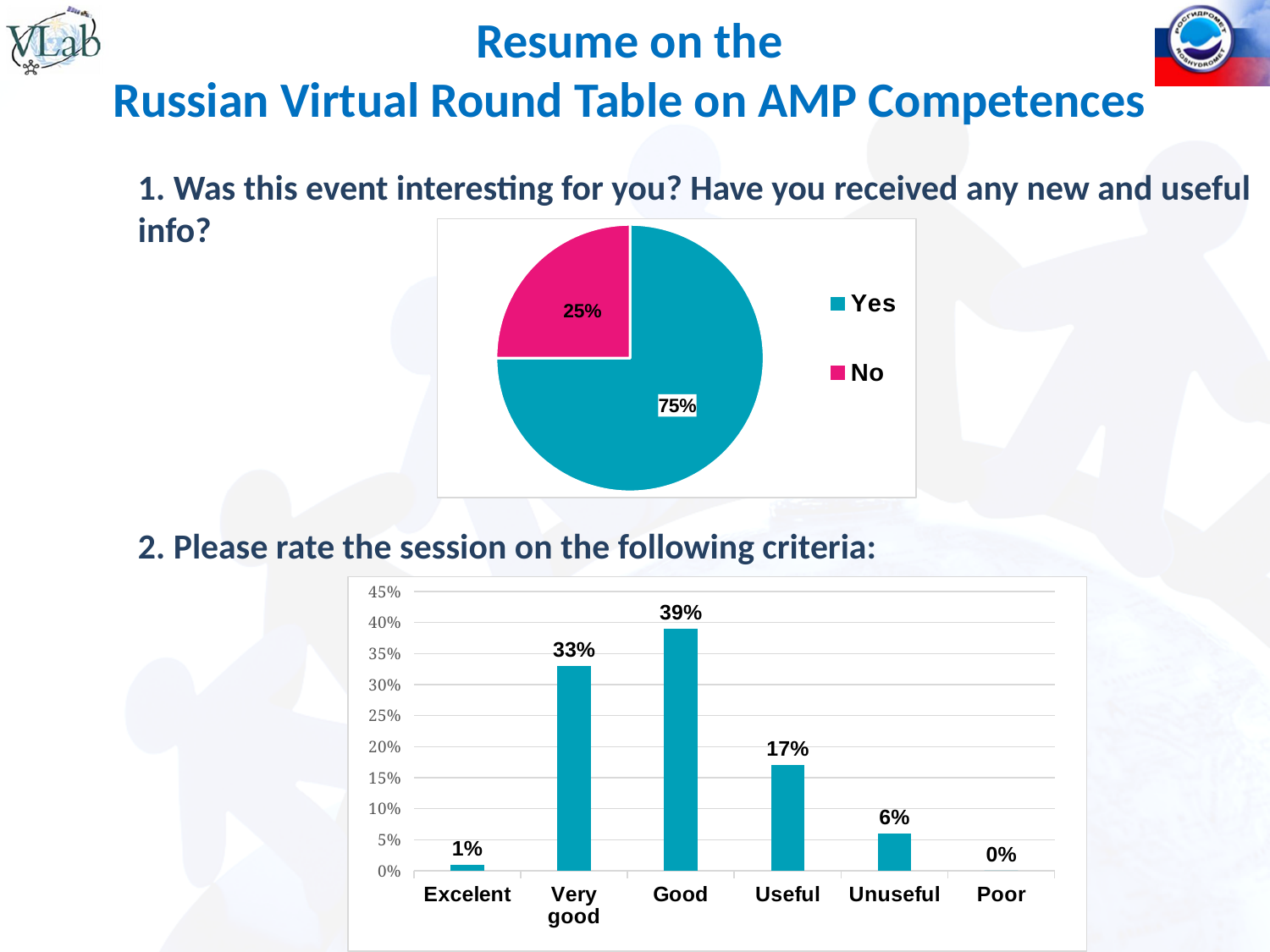
In the pie chart under question 1, what share of respondents answered Yes? 75% What kind of chart is shown under question 2? Bar chart In the bar chart under question 2, what is the value for Useful? 17% What kind of chart is shown under question 1? Pie chart In the bar chart under question 2, which category has the highest value? Good In the pie chart under question 1, which answer has the larger share, Yes or No? Yes In the bar chart under question 2, how many categories are shown on the x axis? 6 In the bar chart under question 2, what is the difference between the values for Good and Very good? 6% In the bar chart under question 2, what is the value for Good? 39% In the pie chart under question 1, how many slices does the pie have? 2 In the bar chart under question 2, which category has the lowest value? Poor In the pie chart under question 1, what share of respondents answered No? 25%